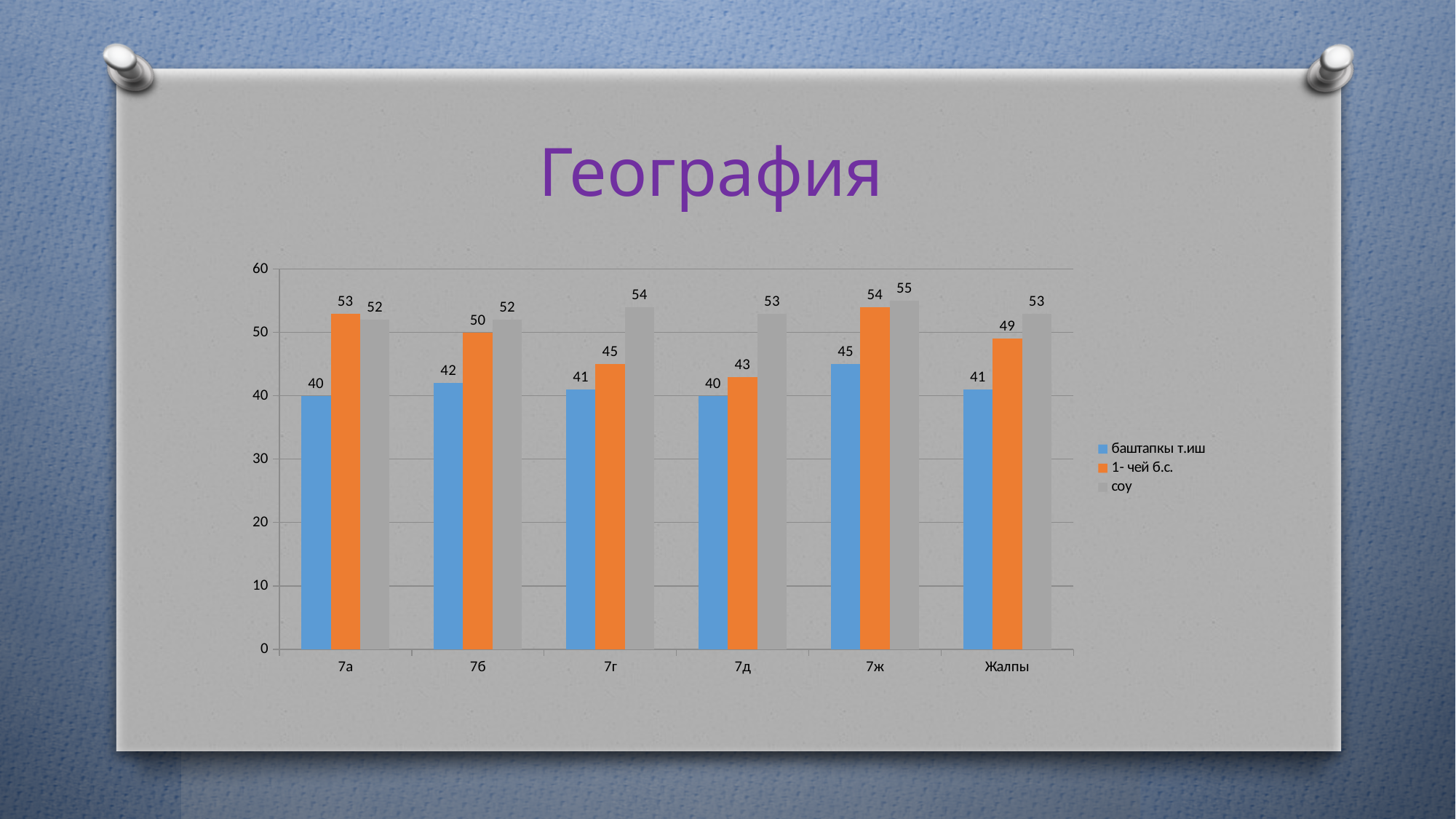
How many categories are shown on the x axis? 6 What is the value of соу for Жалпы? 53 Which category has the highest value for соу? 7ж Which is larger for 7а: 1- чей б.с. or соу? 1- чей б.с. What is the value of баштапкы т.иш for 7ж? 45 What type of chart is shown on the slide? bar chart How many series does the legend list? 3 What is the title of the slide above the chart? География What is the difference between соу and баштапкы т.иш for 7г? 13 Is the value of 1- чей б.с. for 7б greater or less than 40? greater Which category has the lowest value for 1- чей б.с.? 7д What is the value of 1- чей б.с. for 7д? 43